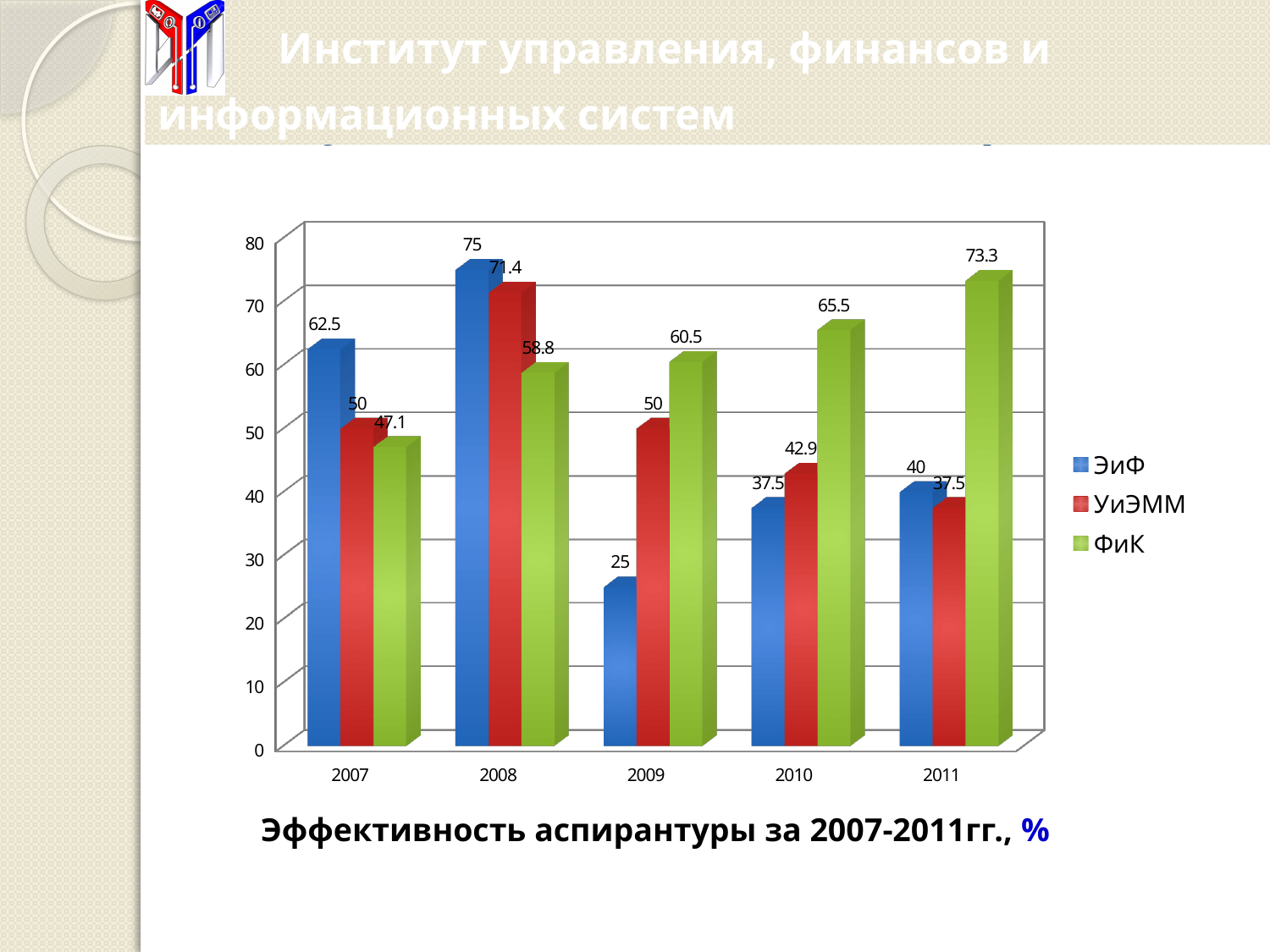
Do the ФиК values rise or fall from 2008 to 2011? Rise How many years are shown on the x axis? 5 What is the value for ФиК in 2011? 73.3 How many series does the legend list? 3 What is the value for УиЭММ in 2010? 42.9 In which year is the ФиК value highest? 2011 What is the value for ЭиФ in 2008? 75 What is the difference between the ФиК and ЭиФ values in 2009? 35.5 In which year is the ЭиФ value lowest? 2009 Which is larger in 2007, the value for ЭиФ or the value for ФиК? ЭиФ What kind of chart is shown on the slide? Bar chart Which colour represents the УиЭММ series in the legend? Red